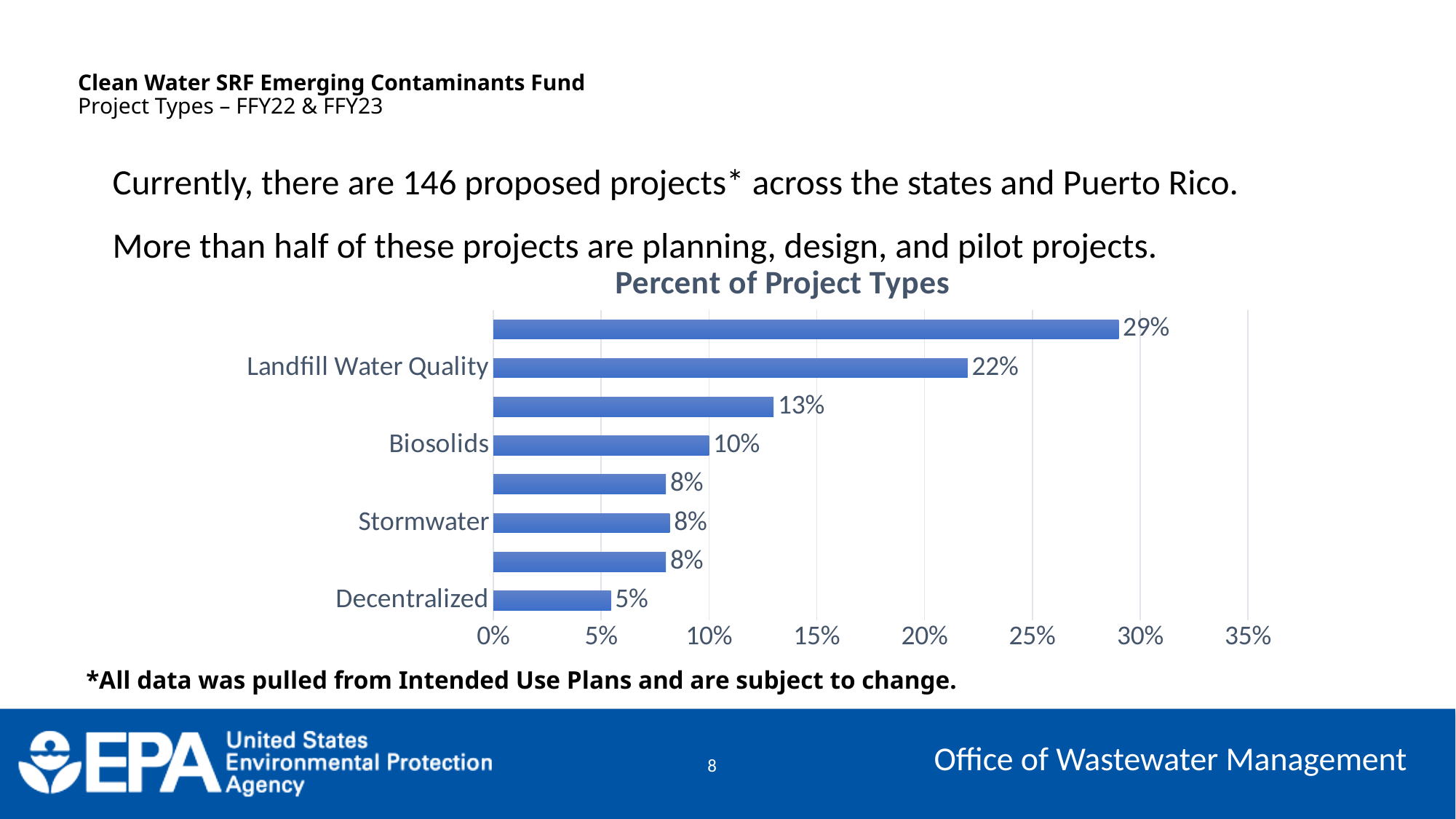
Which labeled category has the lowest value? Decentralized How many bars are plotted on the chart? 8 What is the value for Landfill Water Quality? 22% What is the value for Decentralized? 5% What is the difference between the values for Landfill Water Quality and Biosolids? 12% What is the title of the chart? Percent of Project Types What is the value for Stormwater? 8% What is the largest value shown on the chart? 29% Which is larger, the value for Stormwater or the value for Decentralized? Stormwater What kind of chart is shown on the slide? Bar chart What is the value for Biosolids? 10% Is the value for Landfill Water Quality greater or less than 20%? greater